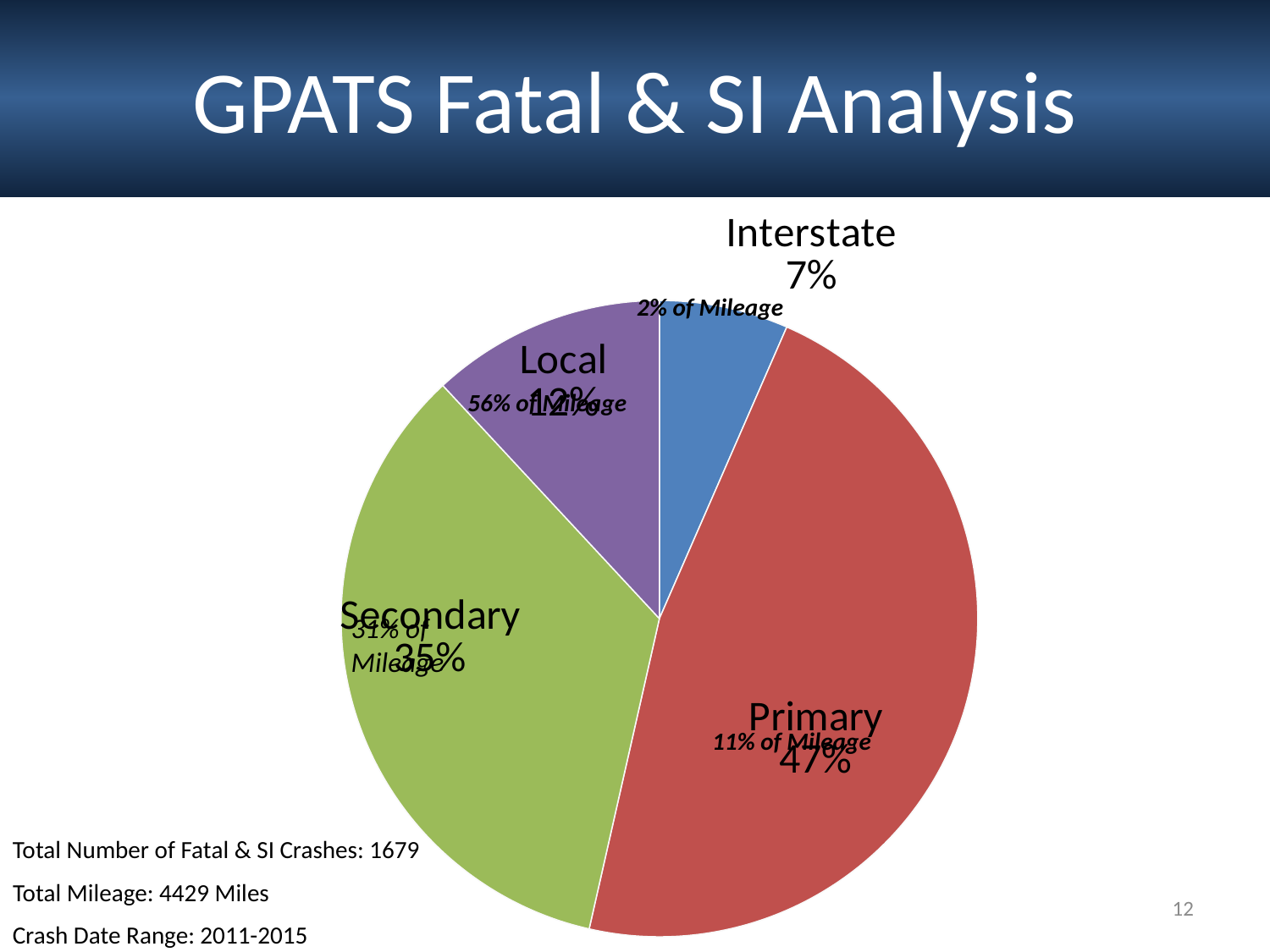
According to the annotation on the Primary slice, what percentage of mileage does Primary account for? 11% of Mileage By how many percentage points does the Primary share exceed the Secondary share? 12 percentage points How many slices does the pie chart have? 4 What share of fatal & SI crashes does the Secondary slice represent? 35% What share of fatal & SI crashes does the Primary slice represent? 47% What share of fatal & SI crashes does the Interstate slice represent? 7% Which road category has the largest share of the pie? Primary Which slice is larger, Local or Interstate? Local Which road category has the smallest share of the pie? Interstate Which slice is larger, Secondary or Primary? Primary According to the annotation on the Interstate slice, what percentage of mileage does Interstate account for? 2% of Mileage What kind of chart is shown on the slide? pie chart